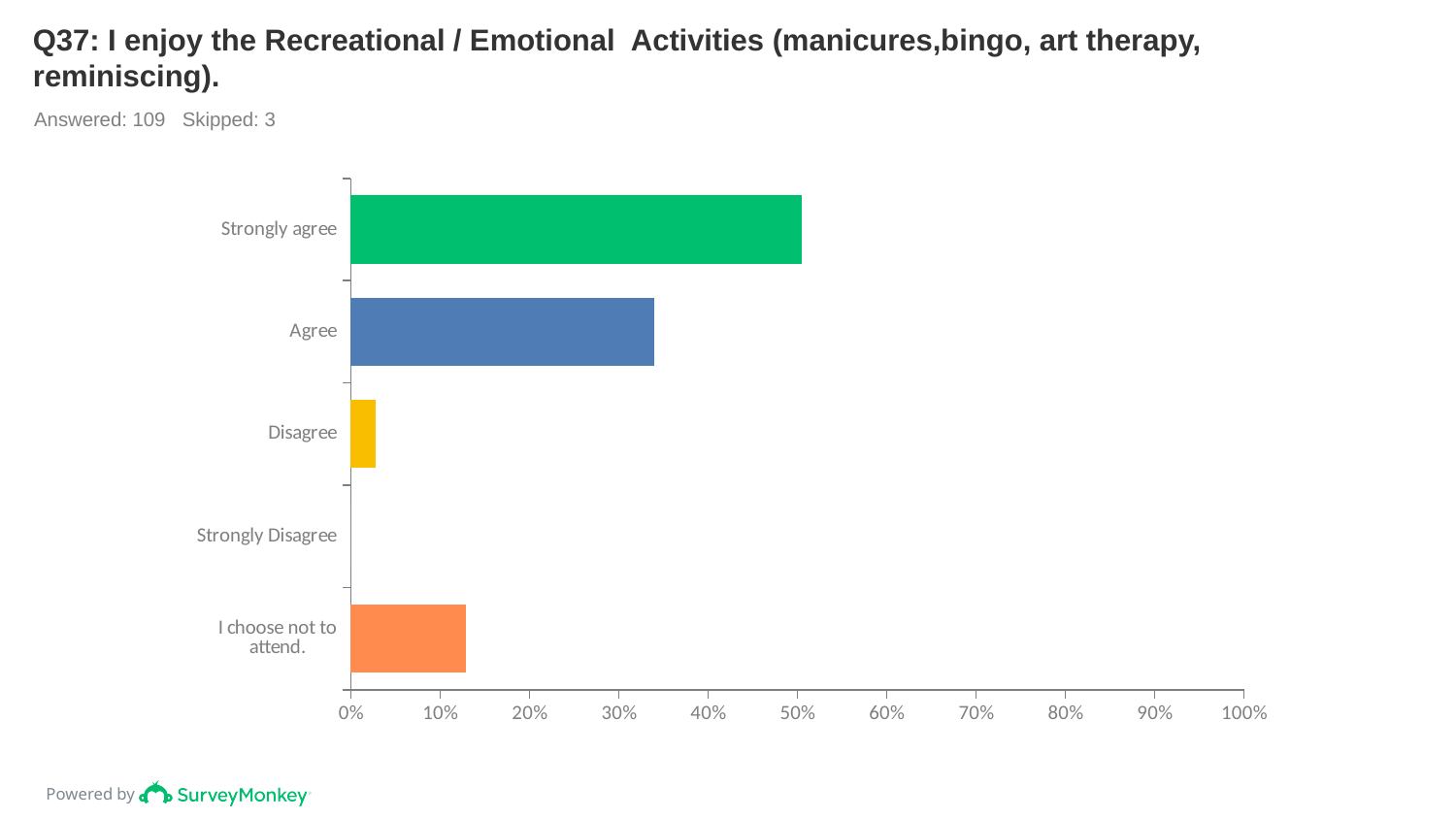
What kind of chart is shown on the slide? bar chart Is the value for Disagree greater or less than 10%? less Which is larger, the value for Agree or the value for "I choose not to attend."? Agree Is the value for Agree greater or less than 40%? less Which response category has the lowest value? Strongly Disagree Is the value for Agree greater or less than 30%? greater Which response category has the highest value? Strongly agree How many respondents answered this question according to the slide? 109 How many response categories are shown on the chart? 5 What colour is the bar for Strongly agree? green